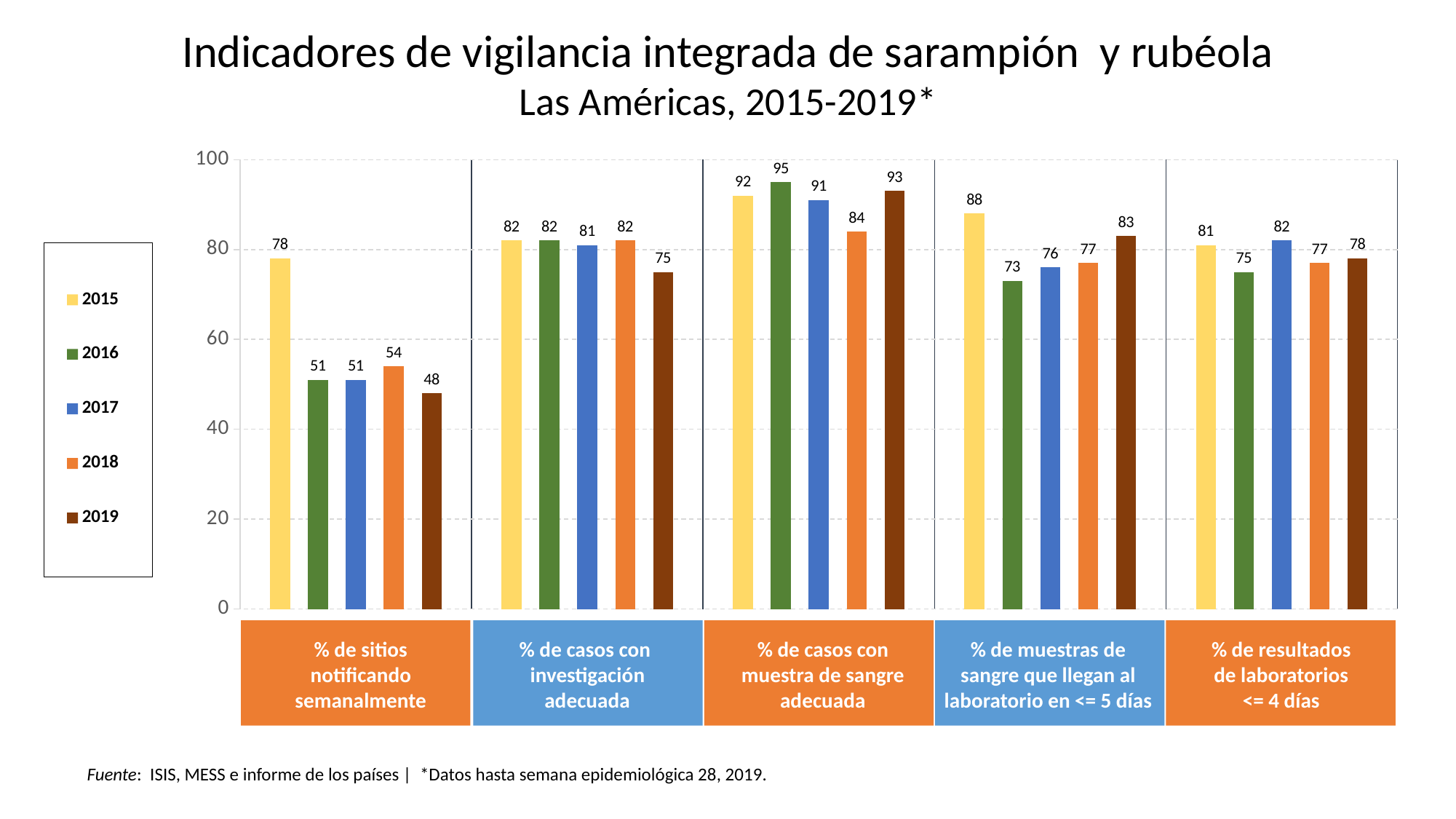
What is the value for 2016 in the '% de muestras de sangre que llegan al laboratorio en <= 5 días' category? 73 What is the difference between the 2015 and 2019 values in the '% de sitios notificando semanalmente' category? 30 Which year has the highest value in the '% de casos con muestra de sangre adecuada' category? 2016 What is the value for 2015 in the '% de sitios notificando semanalmente' category? 78 How many series does the legend list? 5 Which year has the lowest value in the '% de sitios notificando semanalmente' category? 2019 What is the value for 2019 in the '% de casos con muestra de sangre adecuada' category? 93 How many indicator categories are shown on the x axis? 5 Is the value for 2018 in the '% de casos con investigación adecuada' category greater or less than 60? greater What kind of chart is shown on the slide? bar chart Which colour represents the year 2017 in the legend? blue Which is larger in the '% de resultados de laboratorios <= 4 días' category: the 2017 value or the 2016 value? 2017